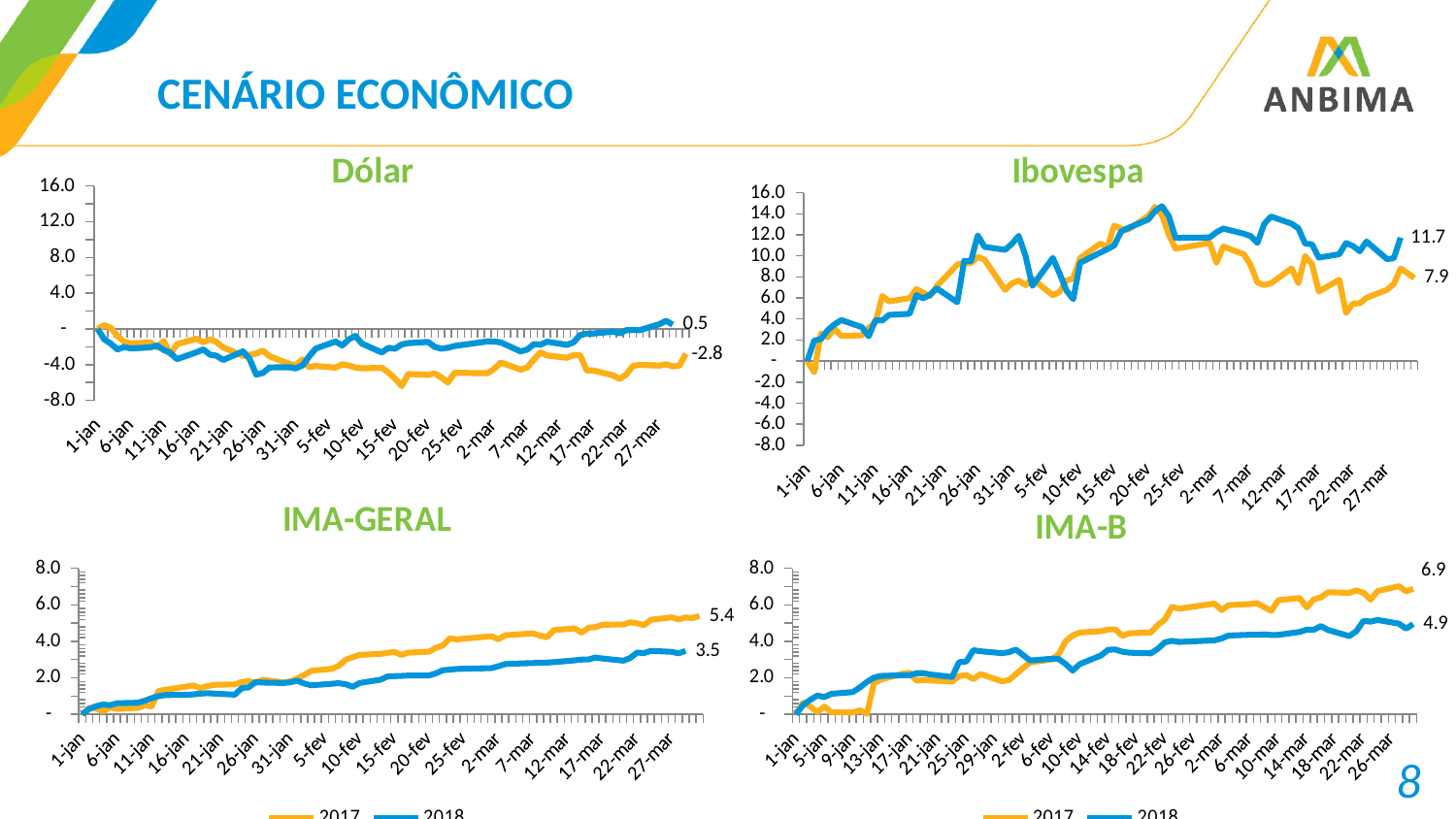
On the Ibovespa chart, what is the final value labelled at the end of the blue line? 11.7 On the Ibovespa chart, what is the final value labelled at the end of the orange line? 7.9 On the IMA-B chart, what is the difference between the final values of the orange line (6.9) and the blue line (4.9)? 2.0 On the IMA-GERAL chart, do the values of the orange line generally rise or fall from January to March? rise How many charts are shown on the slide? 4 On the IMA-B chart, what is the final value labelled at the end of the blue line? 4.9 What kind of chart is the Ibovespa chart? line chart On the Ibovespa chart, what is the difference between the final values of the blue line (11.7) and the orange line (7.9)? 3.8 On the IMA-GERAL chart, what is the final value labelled at the end of the orange line? 5.4 On the IMA-GERAL chart, which line ends at a higher value, the orange line or the blue line? the orange line On the Dólar chart, what is the final value labelled at the end of the orange line? -2.8 On the Dólar chart, what is the final value labelled at the end of the blue line? 0.5